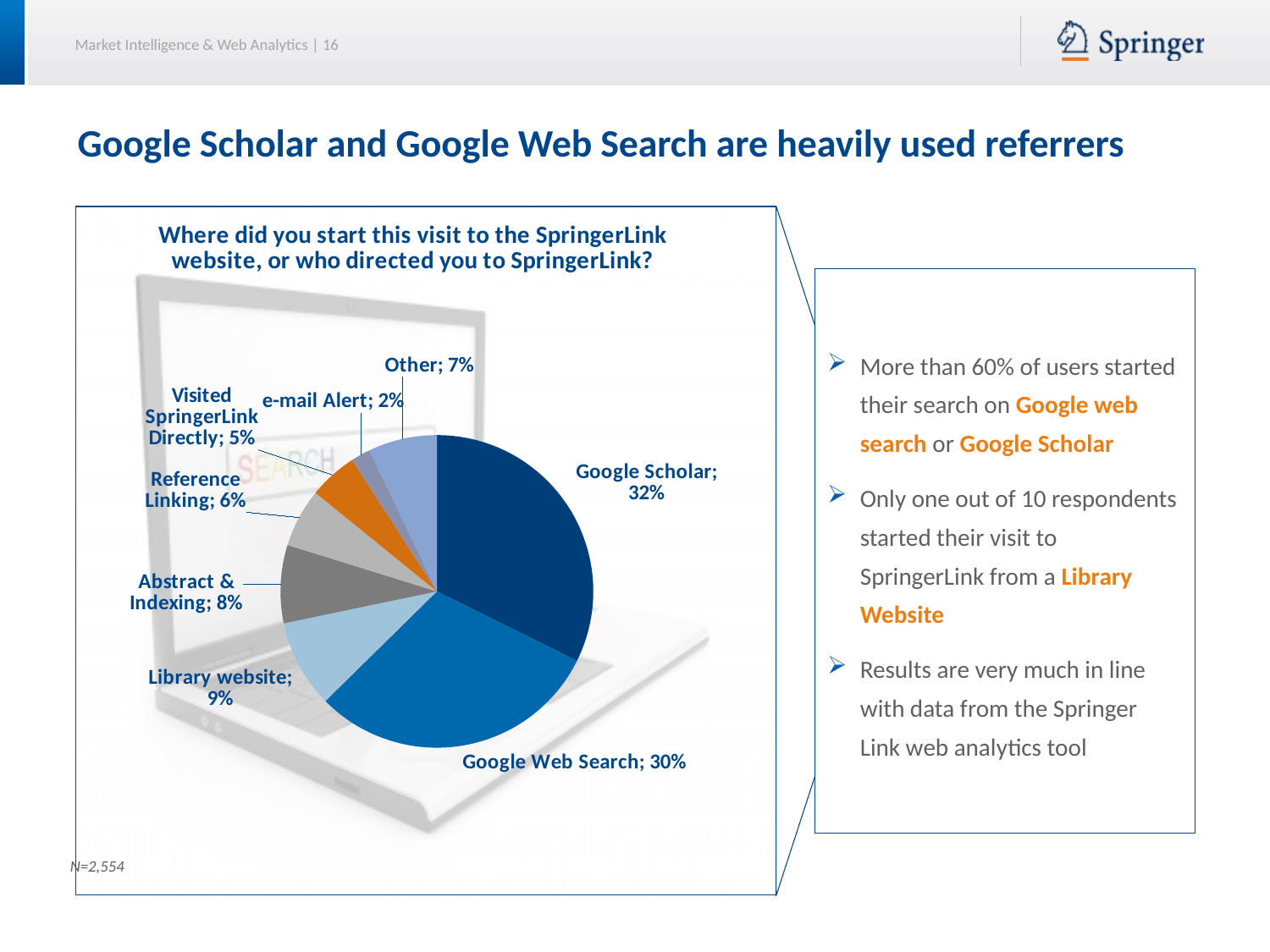
What percentage is shown for Google Web Search? 30% What share of respondents started their visit from Google Scholar? 32% What is the title of the chart? Where did you start this visit to the SpringerLink website, or who directed you to SpringerLink? What is the combined share of Google Scholar and Google Web Search? 62% What type of chart is shown on the slide? Pie chart What is the difference in percentage points between Google Scholar and Google Web Search? 2 How many categories are shown in the pie chart? 8 What percentage of respondents came via e-mail Alert? 2% Which category has the smallest slice of the pie? e-mail Alert What is the value for Library website? 9% Which category has the largest slice of the pie? Google Scholar Which is larger, the share for Abstract & Indexing or the share for Reference Linking? Abstract & Indexing